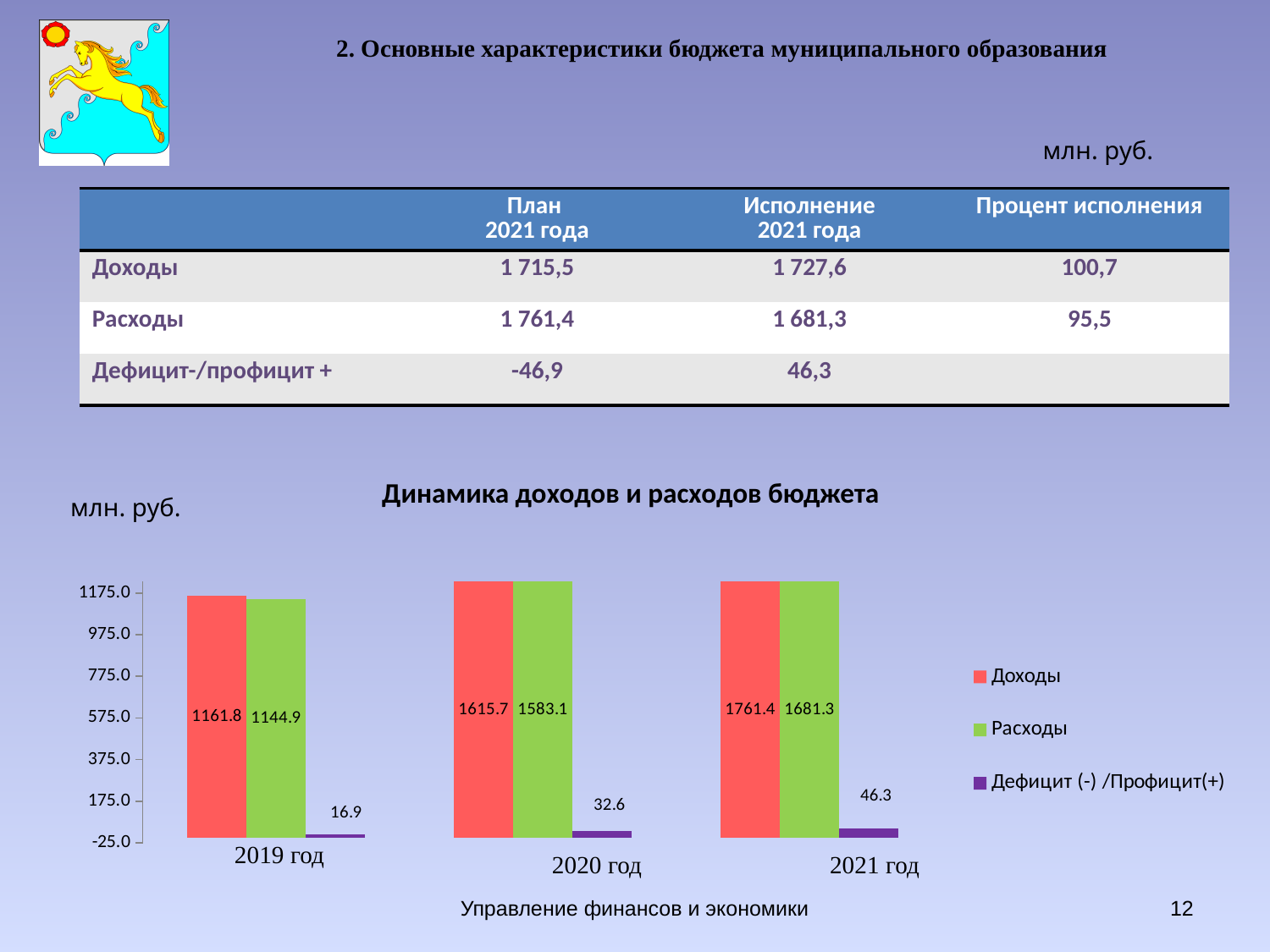
In the chart 'Динамика доходов и расходов бюджета', what is the difference between Доходы and Расходы for 2021 год? 80.1 In the chart 'Динамика доходов и расходов бюджета', do the Расходы values rise or fall from 2019 год to 2021 год? rise In the chart 'Динамика доходов и расходов бюджета', which year has the highest Доходы value? 2021 год What is the value of Доходы for 2019 год in the chart 'Динамика доходов и расходов бюджета'? 1161.8 What is the value of Дефицит (-) /Профицит(+) for 2021 год in the chart 'Динамика доходов и расходов бюджета'? 46.3 In the chart 'Динамика доходов и расходов бюджета', which year has the lowest Дефицит (-) /Профицит(+) value? 2019 год How many years are shown on the x axis of the chart 'Динамика доходов и расходов бюджета'? 3 In the chart 'Динамика доходов и расходов бюджета', which is larger for 2020 год: Доходы or Расходы? Доходы What kind of chart is 'Динамика доходов и расходов бюджета'? bar chart What is the value of Расходы for 2020 год in the chart 'Динамика доходов и расходов бюджета'? 1583.1 How many series does the legend of the chart 'Динамика доходов и расходов бюджета' list? 3 In the chart 'Динамика доходов и расходов бюджета', is the Дефицит (-) /Профицит(+) value for 2020 год greater or less than 175.0? less